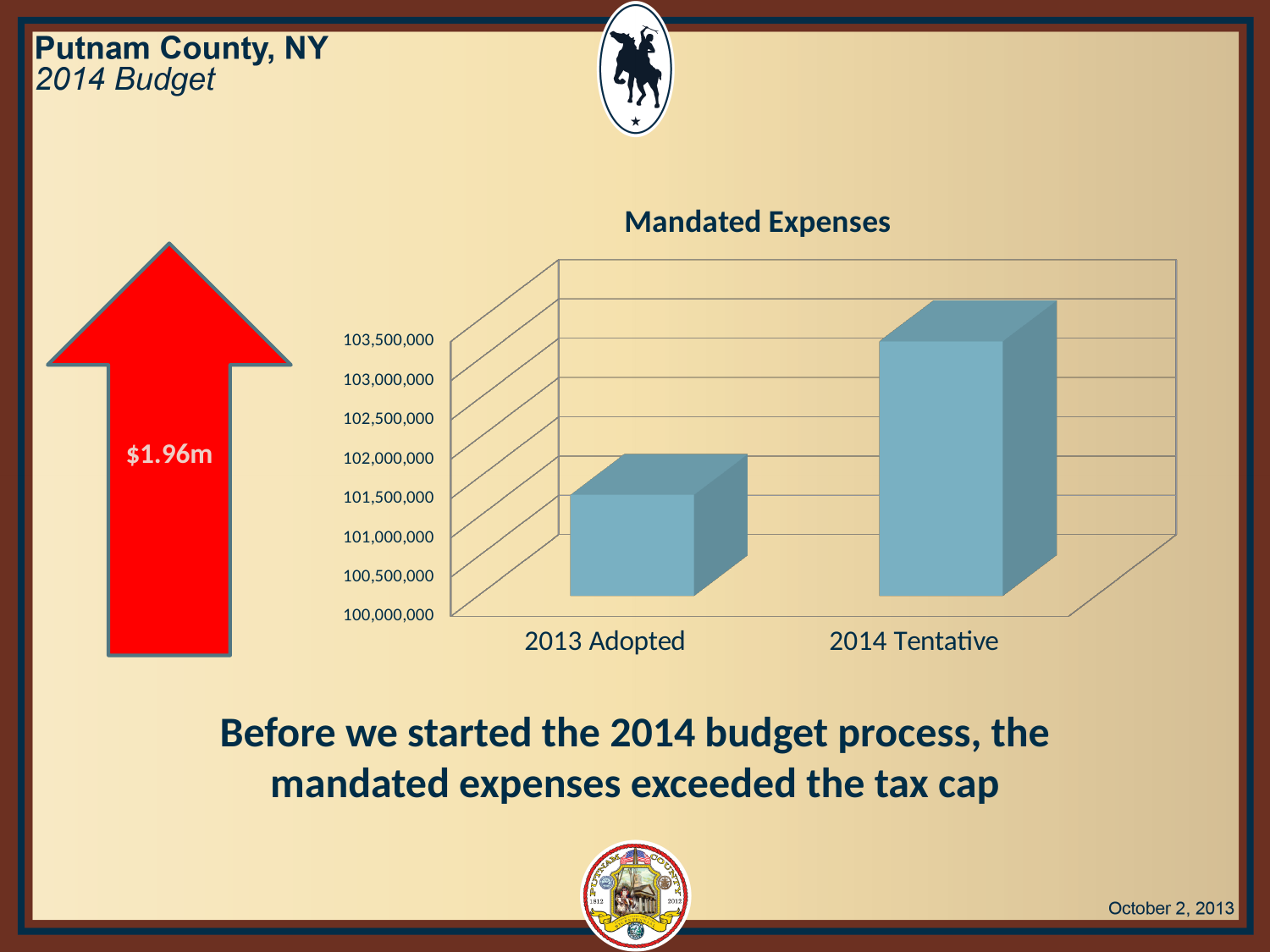
Is the value for 2014 Tentative greater or less than 102,500,000? greater Which is larger, the value for 2013 Adopted or the value for 2014 Tentative? 2014 Tentative Is the value for 2013 Adopted greater or less than 102,500,000? less Is the value for 2014 Tentative greater or less than 103,000,000? greater Which category has the highest value in the Mandated Expenses chart? 2014 Tentative What is the lowest value shown on the y axis of the Mandated Expenses chart? 100,000,000 How many categories are shown on the x axis of the Mandated Expenses chart? 2 What type of chart is shown on the slide? bar chart Which category has the lowest value in the Mandated Expenses chart? 2013 Adopted Do the values rise or fall from 2013 Adopted to 2014 Tentative? rise What is the title of the chart? Mandated Expenses